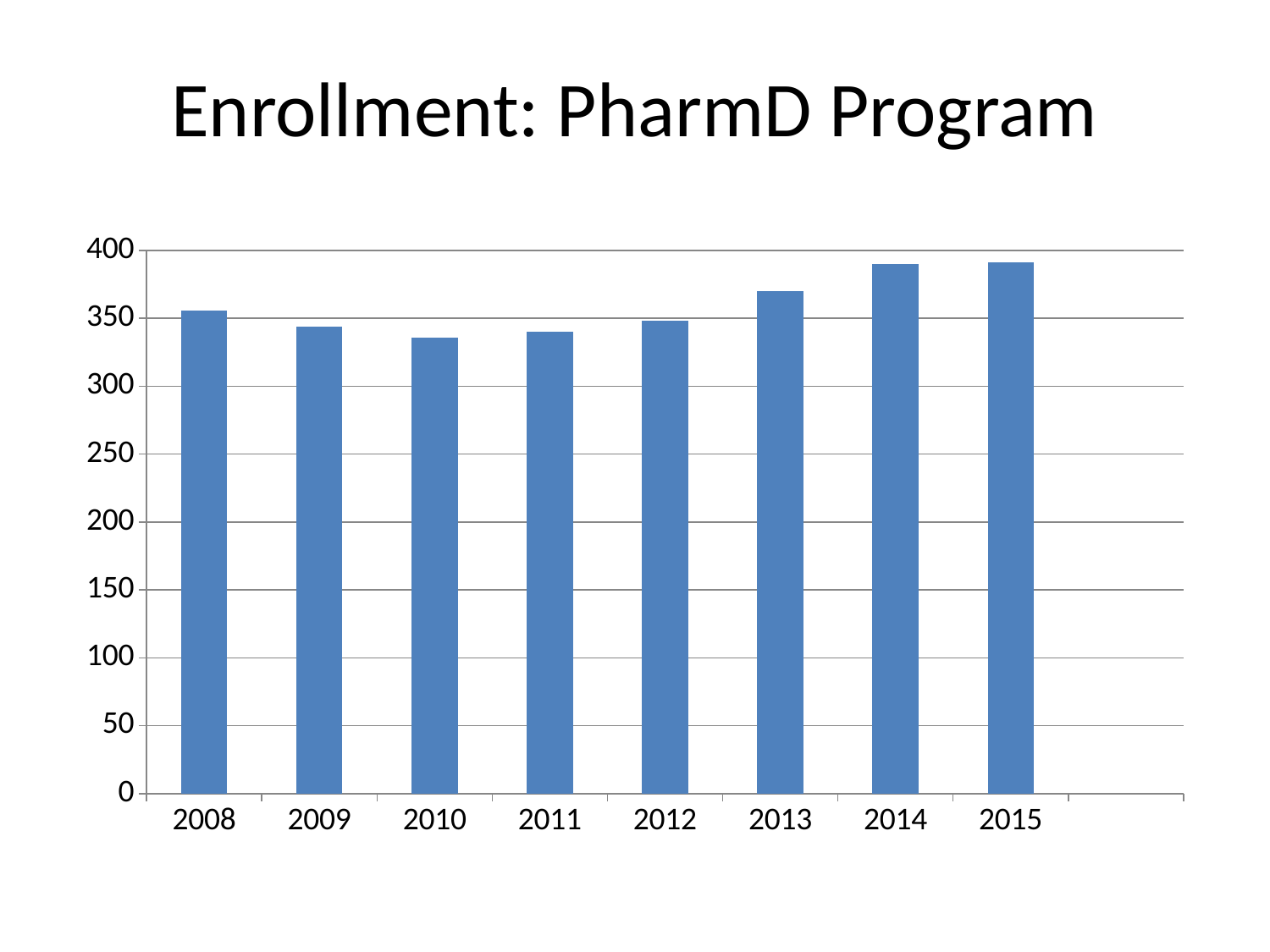
How many years are shown on the x axis of the chart? 8 What is the title of the chart? Enrollment: PharmD Program What kind of chart is shown on the slide? bar chart Is the value for 2013 greater or less than 350? greater Do the values generally rise or fall from 2010 to 2015? rise Is the value for 2008 greater or less than 350? greater Is the value for 2010 greater or less than 350? less Which is larger, the value for 2009 or the value for 2014? 2014 Which is larger, the value for 2008 or the value for 2010? 2008 Which is larger, the value for 2012 or the value for 2013? 2013